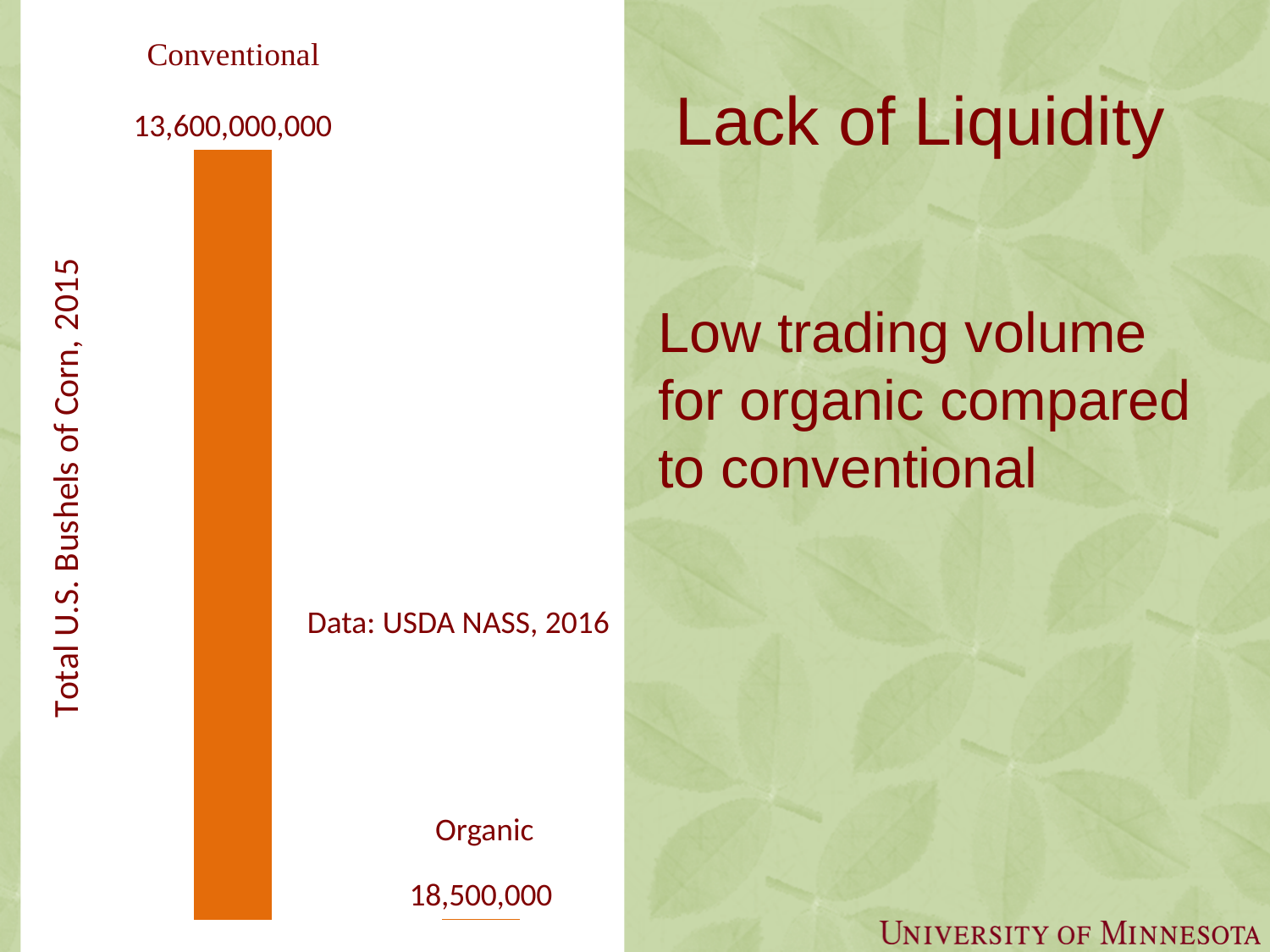
What is the value for Conventional in the chart? 13,600,000,000 Which category has the lowest value in the chart? Organic What is the difference between the Conventional and Organic values? 13,581,500,000 Which is larger, the value for Conventional or the value for Organic? Conventional What data source is cited for the chart? USDA NASS, 2016 Which category has the highest value in the chart? Conventional What is the value for Organic in the chart? 18,500,000 How many categories are plotted in the chart? 2 What kind of chart is shown on the slide? Bar chart What is the label on the vertical axis of the chart? Total U.S. Bushels of Corn, 2015